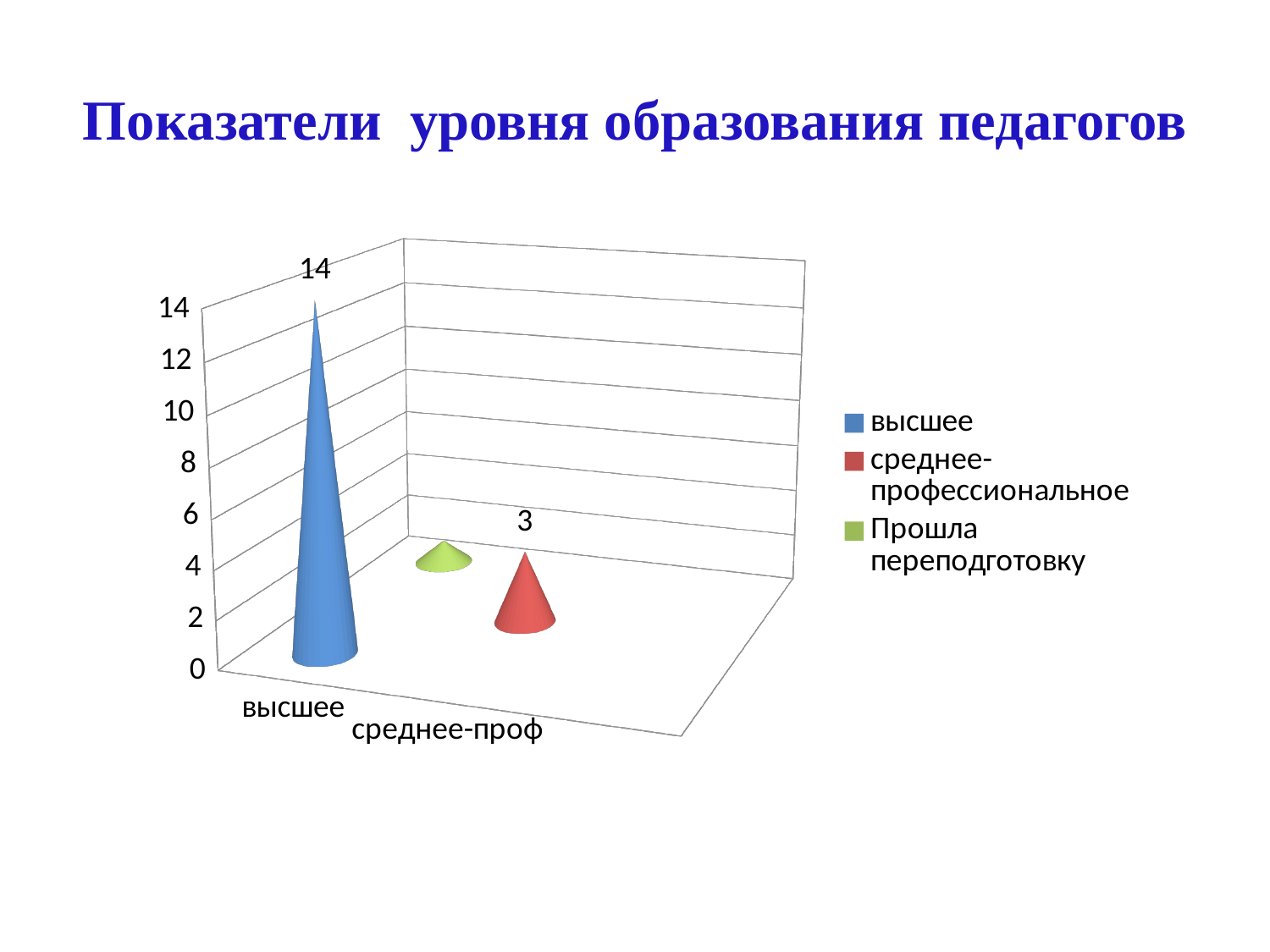
Which series has the lowest value? Прошла переподготовку Is the value for "высшее" greater or less than 10? greater What is the value for the series "высшее"? 14 What is the difference between the values for "высшее" and "среднее-профессиональное"? 11 Is the value for "Прошла переподготовку" greater or less than 4? less Which is larger, the value for "высшее" or the value for "среднее-профессиональное"? высшее What kind of chart is shown on the slide? bar chart How many series does the legend list? 3 What is the title of the slide? Показатели уровня образования педагогов What colour represents the series "среднее-профессиональное" in the legend? red Which series has the highest value? высшее What is the value for the series "среднее-профессиональное"? 3